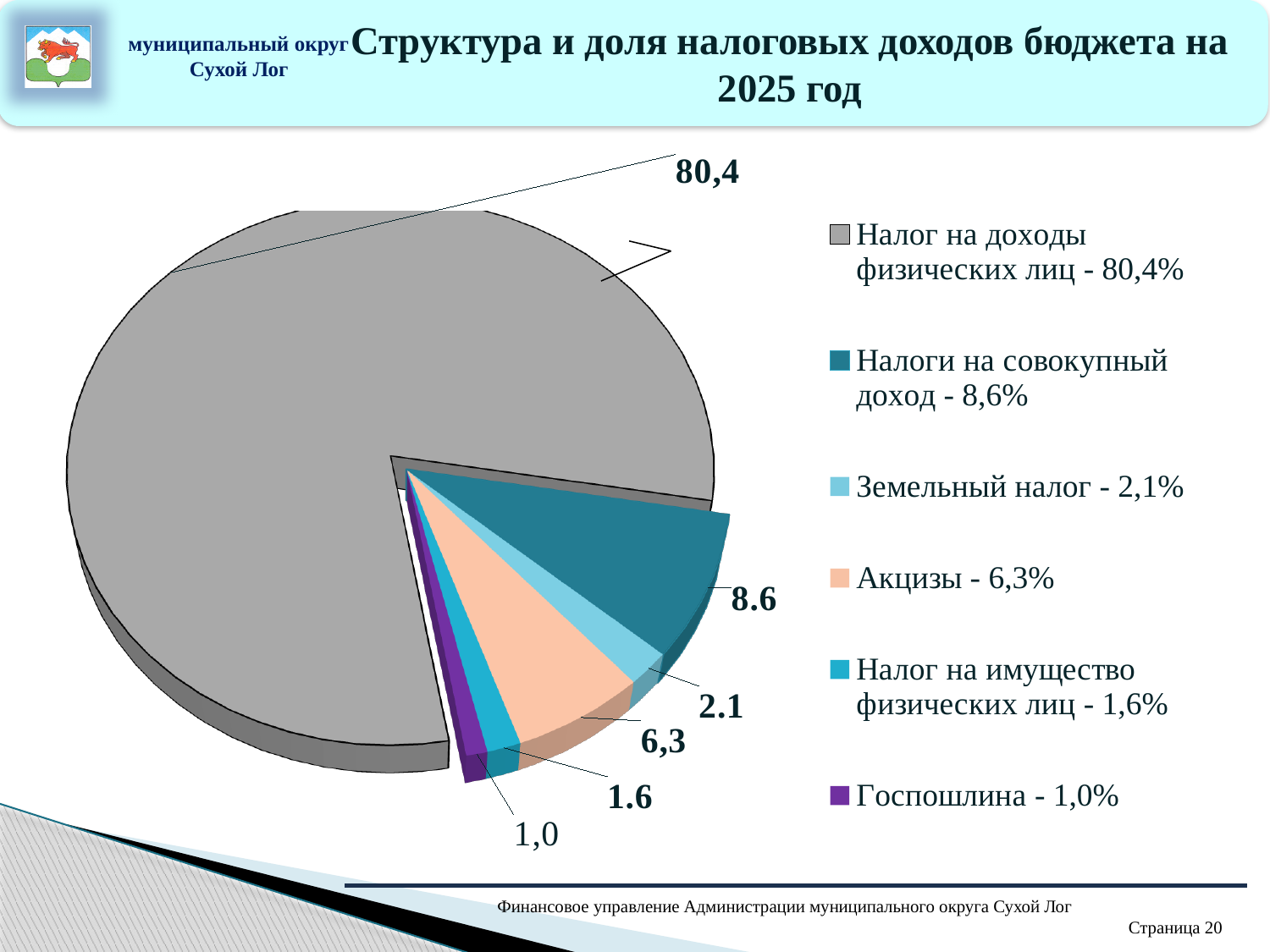
How many categories does the legend of the pie chart list? 6 Which is larger: the share of "Акцизы" or the share of "Земельный налог"? Акцизы Which category has the smallest slice of the pie? Госпошлина What is the share of "Акцизы" in the pie chart? 6,3% What is the title of the slide containing the pie chart? Структура и доля налоговых доходов бюджета на 2025 год What is the share of "Земельный налог"? 2,1% What share does "Госпошлина" have? 1,0% What share does "Налоги на совокупный доход" have in the pie chart? 8,6% What share of tax revenues does "Налог на доходы физических лиц" account for? 80,4% Which category has the largest slice of the pie? Налог на доходы физических лиц What is the difference in percentage points between "Налог на доходы физических лиц" and "Налоги на совокупный доход"? 71,8 What kind of chart is shown on the slide? Pie chart